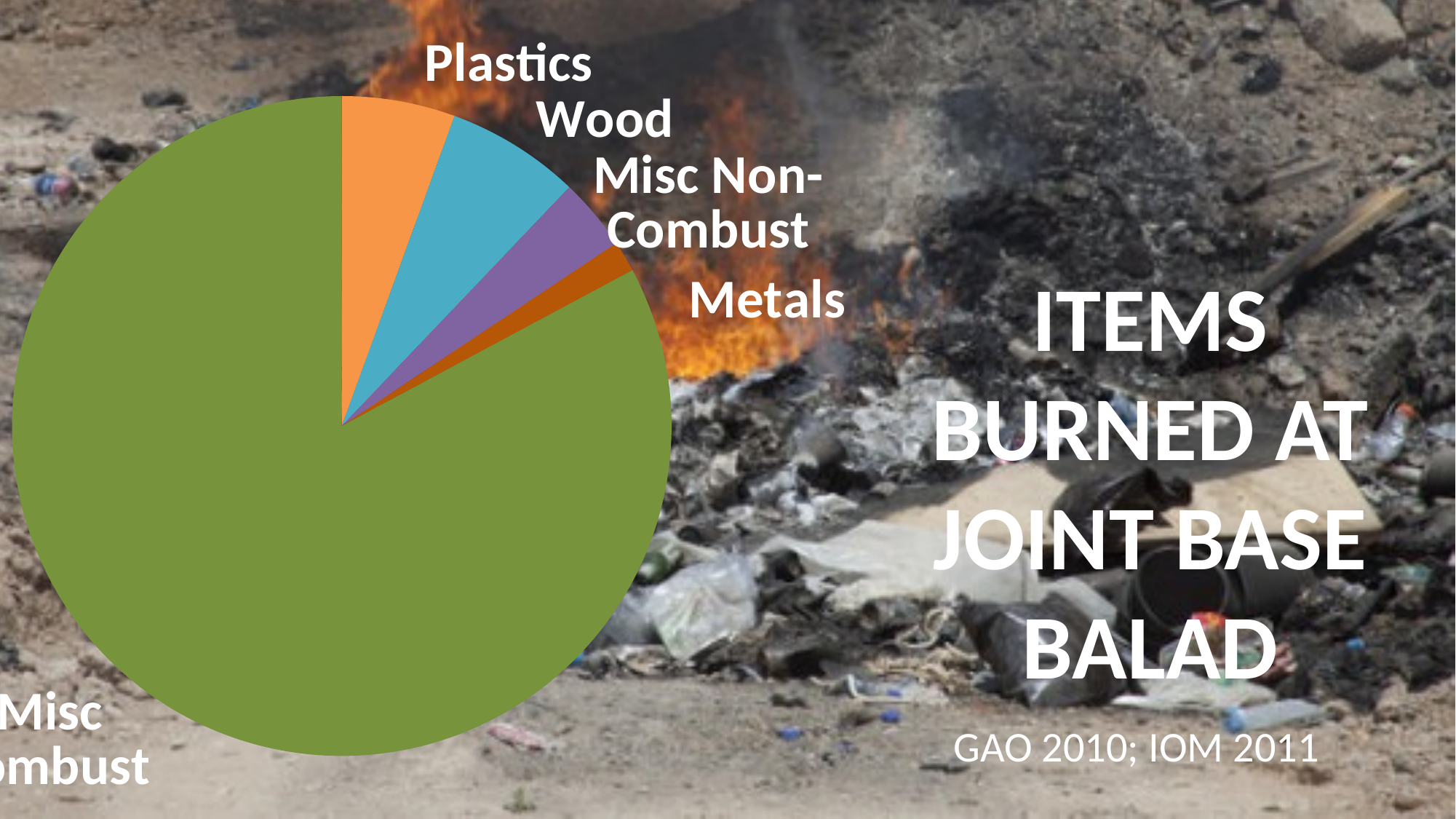
Which slice is larger, Wood or Metals? Wood Which slice is larger, Misc Non-Combust or Metals? Misc Non-Combust What colour is the Wood slice in the pie chart? blue Which of the labelled slices is the smallest in the pie chart? Metals What kind of chart is shown on the slide? pie chart What is the title of the chart on the slide? ITEMS BURNED AT JOINT BASE BALAD Which slice is larger, Plastics or Metals? Plastics How many slices does the pie chart have? 5